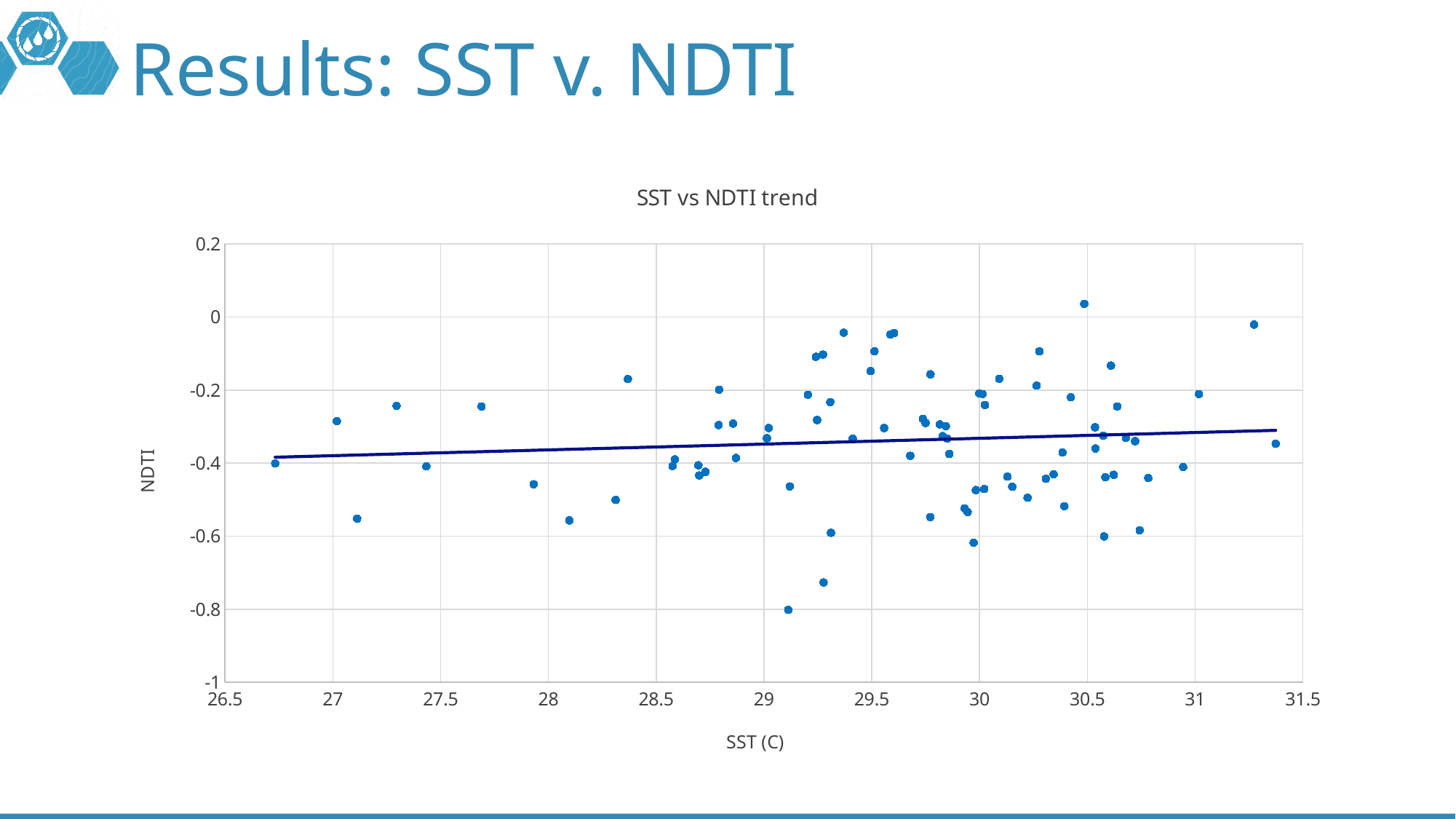
Does the trend line rise or fall as SST increases along the x axis? rise What is the title of the chart? SST vs NDTI trend What is the minimum value shown on the y axis? -1 What is the maximum value shown on the x axis? 31.5 Is the trend line's value at SST 31 greater or less than -0.4? greater Is the trend line's value at SST 27 greater or less than -0.2? less What kind of chart is shown on the slide? scatter plot What is the label of the x axis? SST (C) Is the highest NDTI point on the chart greater or less than 0? greater